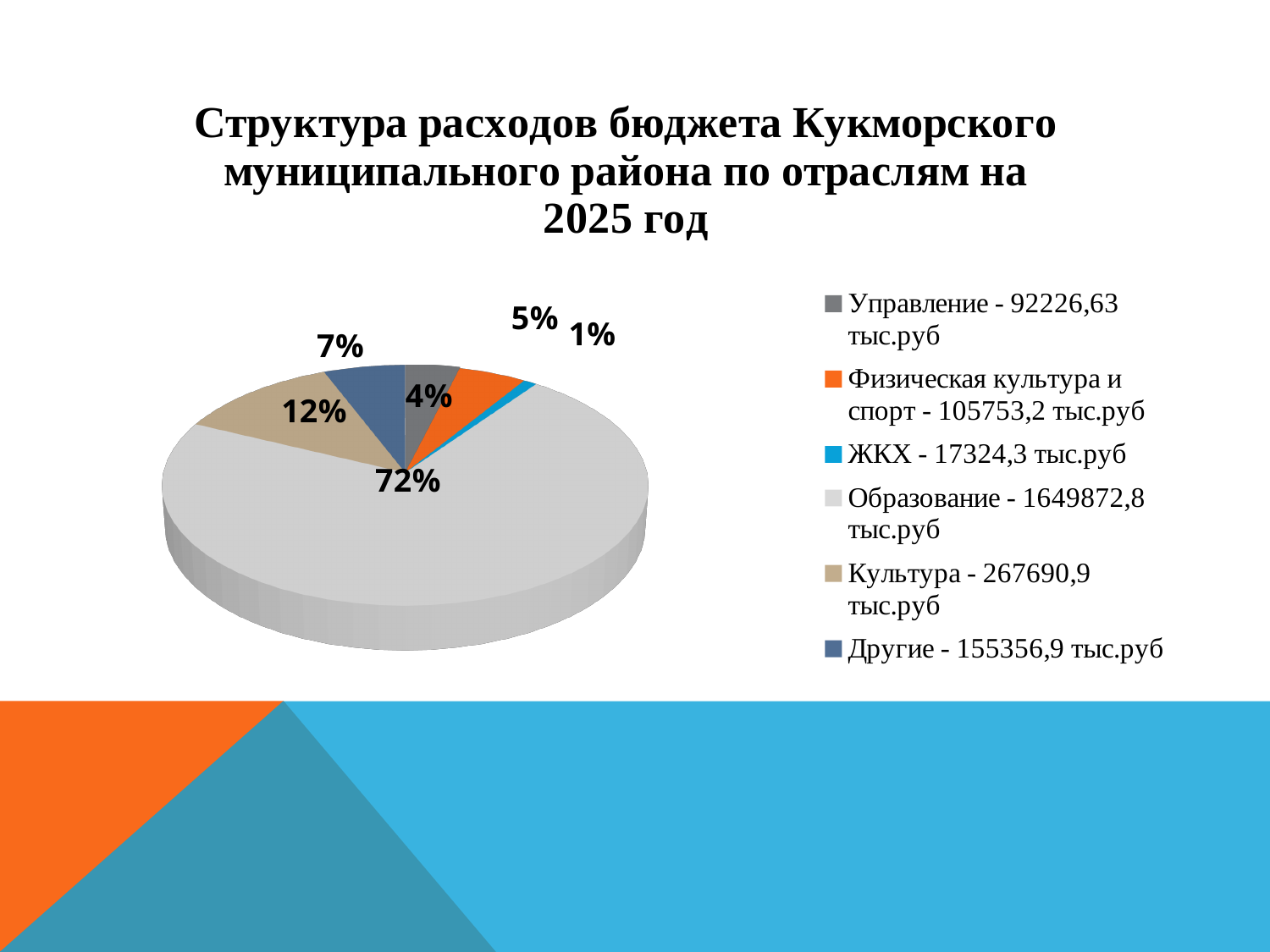
What amount in тыс.руб is listed in the legend for Образование? 1649872,8 тыс.руб What share of the pie does Образование take? 72% Which slice is larger, Культура or Другие? Культура What share of the pie does Управление take? 4% What kind of chart is shown on the slide? Pie chart What share of the pie does Другие take? 7% What is the difference in percentage points between the Образование slice and the Культура slice? 60 percentage points How many categories are shown in the pie chart? 6 Which category has the smallest slice of the pie? ЖКХ Which category has the largest slice of the pie? Образование